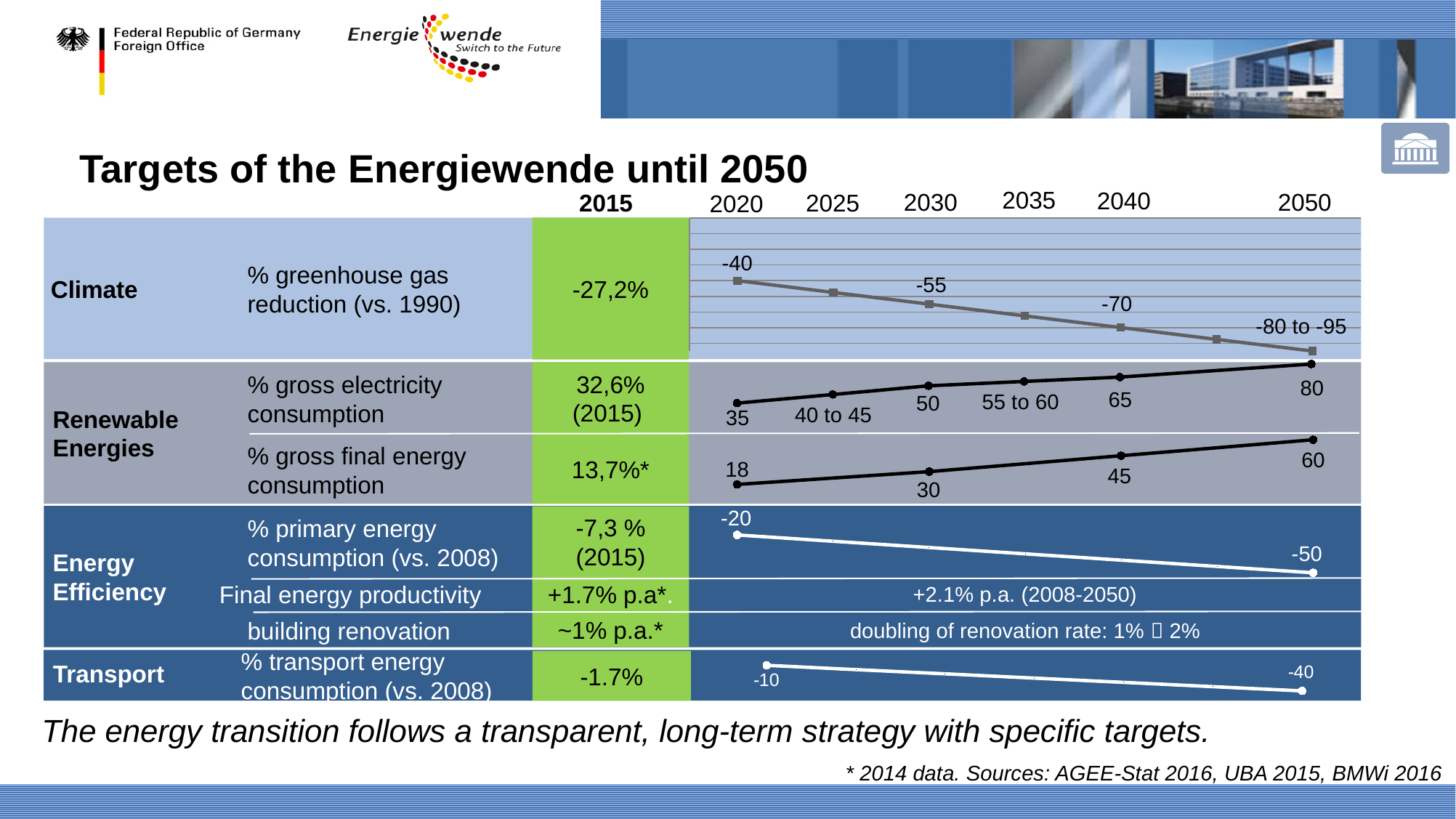
In the % gross electricity consumption chart, do the target values rise or fall from 2020 to 2050? rise What kind of chart is used to show the % greenhouse gas reduction (vs. 1990) targets? line chart In the % primary energy consumption (vs. 2008) chart, what is the target value for 2050? -50 In the % greenhouse gas reduction (vs. 1990) chart, what is the target value for 2050? -80 to -95 In the % gross final energy consumption chart, which year has the highest target value? 2050 In the % gross electricity consumption chart, what is the target value for 2025? 40 to 45 In the % transport energy consumption (vs. 2008) chart, what is the target value for 2020? -10 In the % gross electricity consumption chart, what is the difference between the 2050 and 2020 targets? 45 In the % greenhouse gas reduction (vs. 1990) chart, what is the target value for 2030? -55 In the % gross electricity consumption chart, what is the target value for 2040? 65 In the % gross final energy consumption chart, what is the target value for 2030? 30